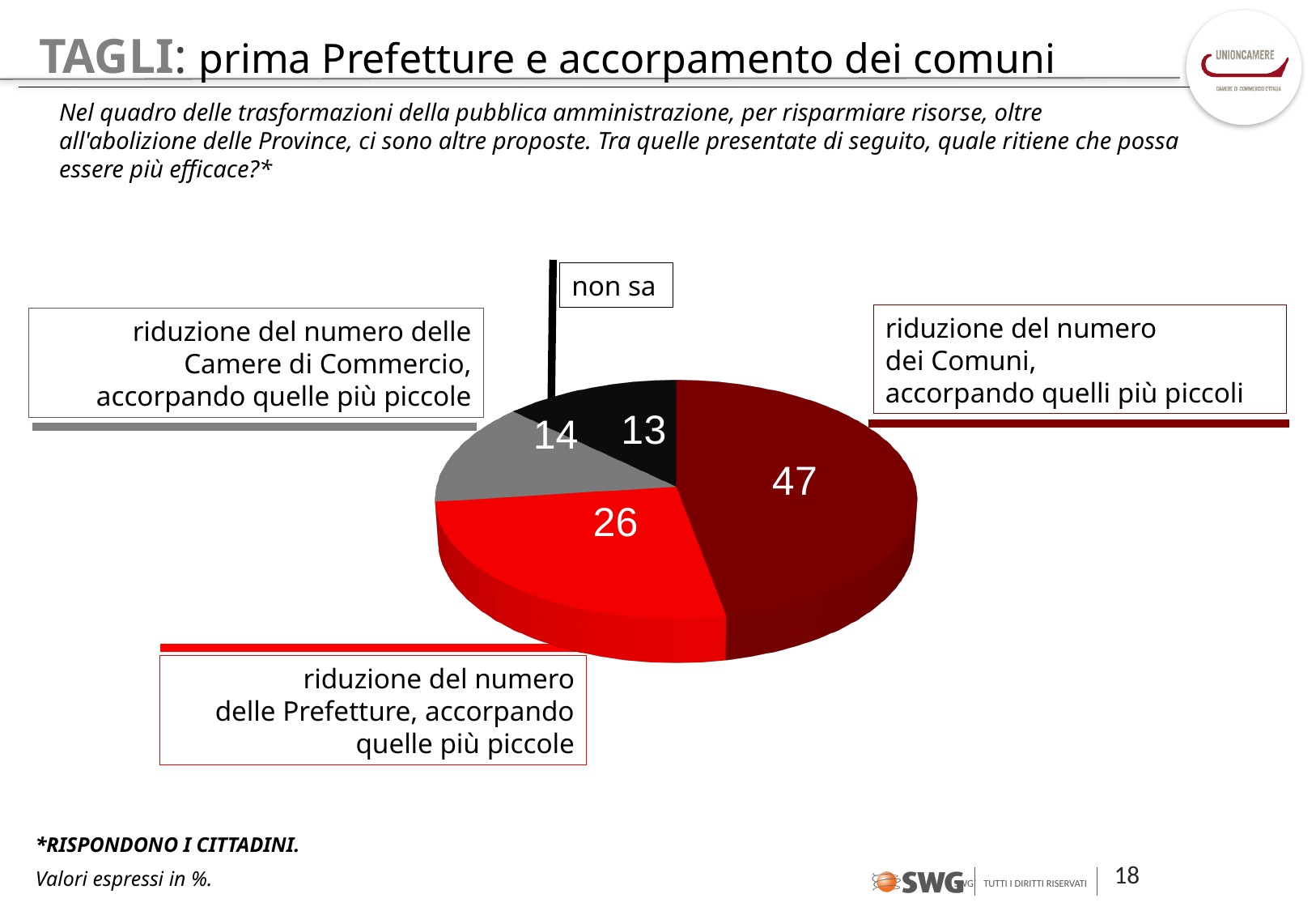
What is the difference between the value for "riduzione del numero dei Comuni" and the value for "riduzione del numero delle Prefetture"? 21 What is the value for "non sa"? 13 What is the value for "riduzione del numero delle Prefetture, accorpando quelle più piccole"? 26 How many slices does the pie chart have? 4 Which category has the largest slice of the pie? riduzione del numero dei Comuni, accorpando quelli più piccoli Which category has the smallest slice of the pie? non sa What colour is the slice for "non sa"? black In what unit are the values in the chart expressed, according to the note at the bottom of the slide? % Which is larger: the value for "riduzione del numero delle Prefetture" or the value for "riduzione del numero delle Camere di Commercio"? riduzione del numero delle Prefetture What is the value for "riduzione del numero dei Comuni, accorpando quelli più piccoli"? 47 What is the value for "riduzione del numero delle Camere di Commercio, accorpando quelle più piccole"? 14 What kind of chart is shown on the slide? pie chart